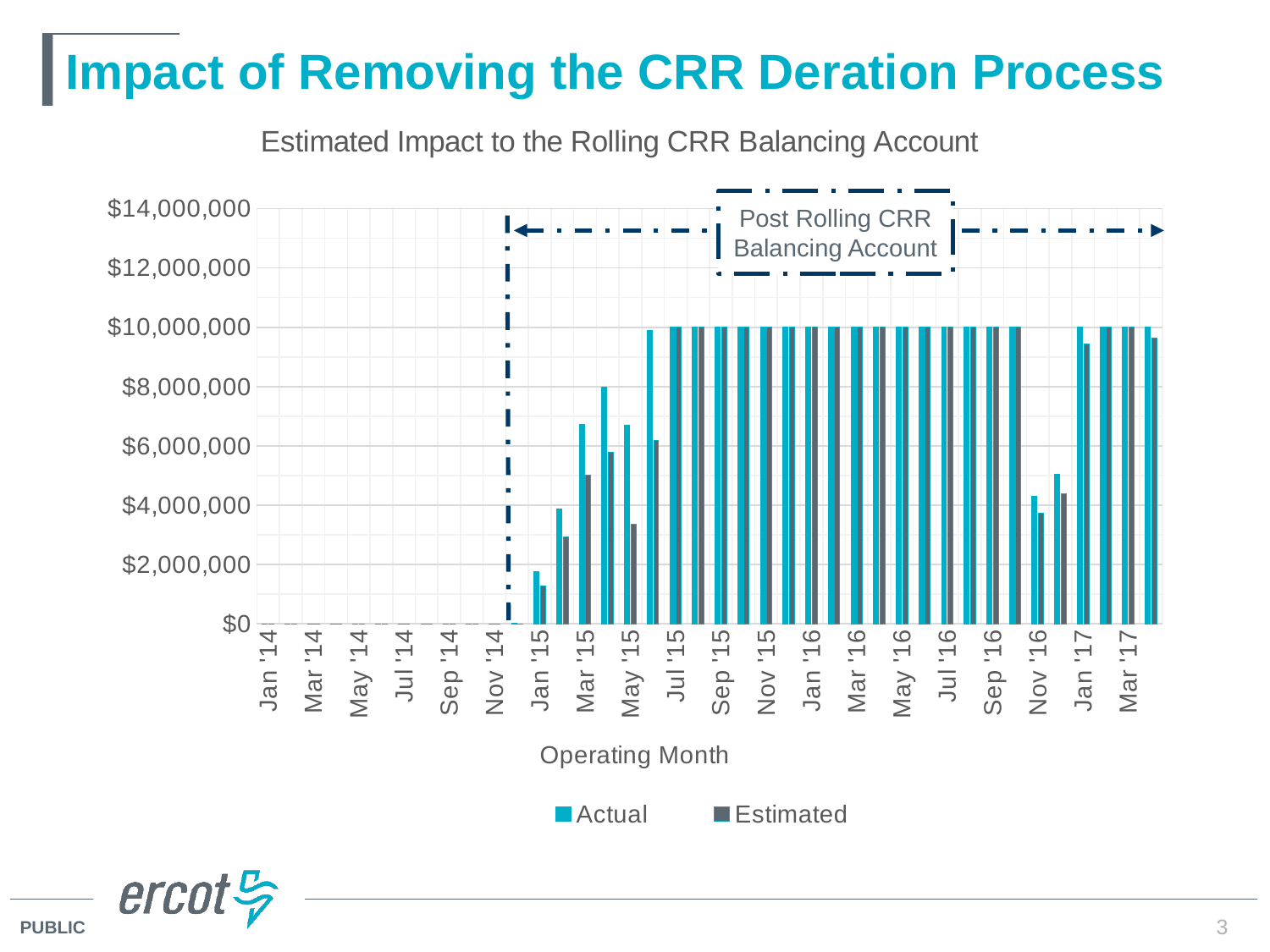
How many series does the legend list? 2 Is the Actual value for Mar '15 greater or less than $6,000,000? greater What is the Actual value for Jan '16? $10,000,000 What kind of chart is shown on the slide? bar chart What is the Actual value for Jan '14? $0 Is the Actual value for Jan '15 greater or less than $2,000,000? less Is the Estimated value for Nov '16 greater or less than $4,000,000? less What is the Estimated value for Mar '16? $10,000,000 What are the two series named in the legend? Actual and Estimated Do the Actual values rise or fall from Jan '15 to Jul '15? rise Which is larger, the Actual value for Jan '15 or the Actual value for Mar '15? Mar '15 What is the title of the x axis? Operating Month